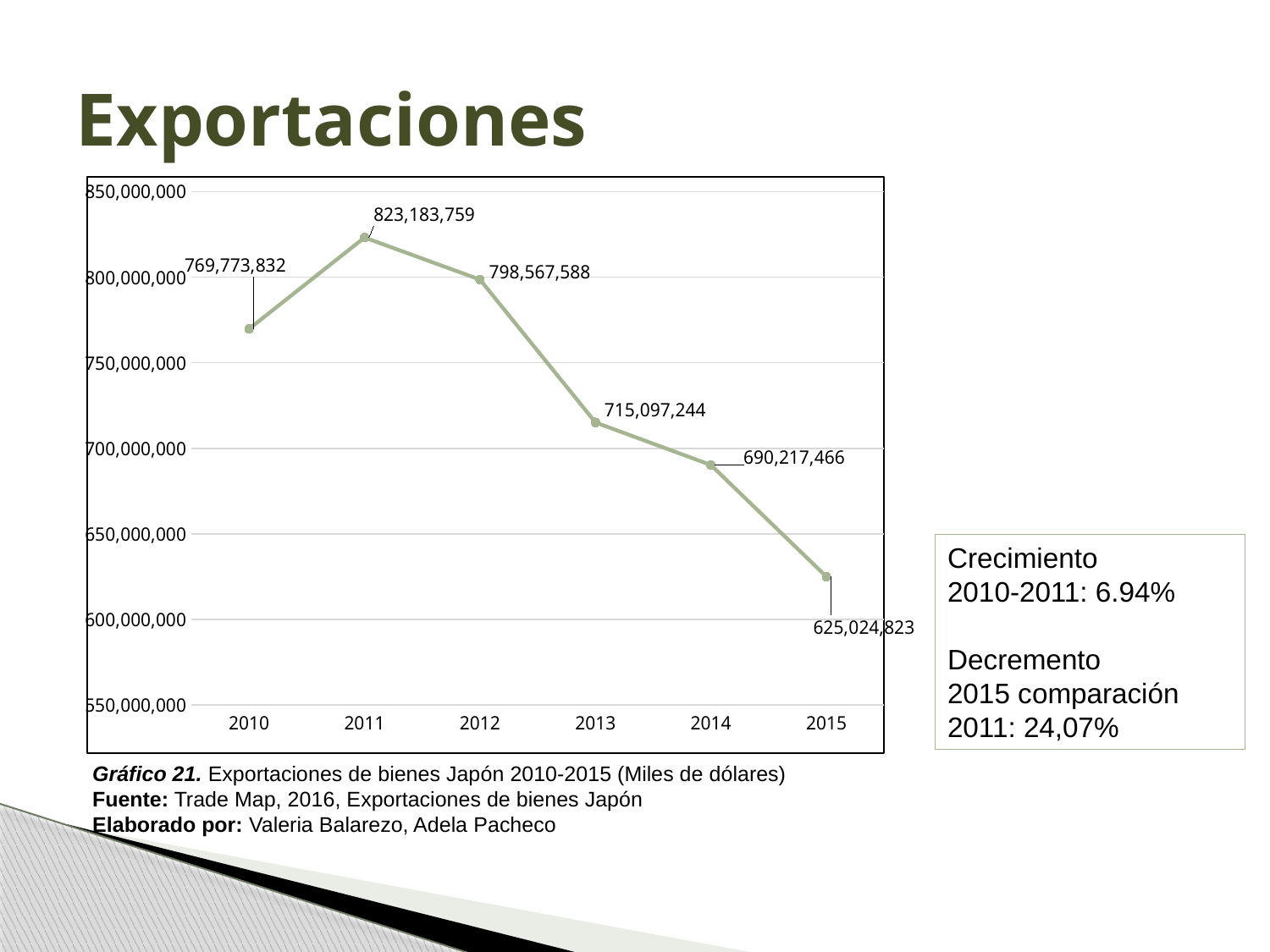
What is the difference between the export values for 2011 and 2010? 53,409,927 What type of chart is shown on the slide? line chart What is the value of exports for 2015? 625,024,823 What is the value of exports for 2013? 715,097,244 What is the value of exports for 2011? 823,183,759 Which year has the highest export value? 2011 How many years are plotted on the chart? 6 What is the difference between the export values for 2011 and 2015? 198,158,936 Do the export values rise or fall from 2011 to 2015? fall Which year has a larger export value, 2012 or 2014? 2012 Is the value for 2014 greater or less than 700,000,000? less Which year has the lowest export value? 2015